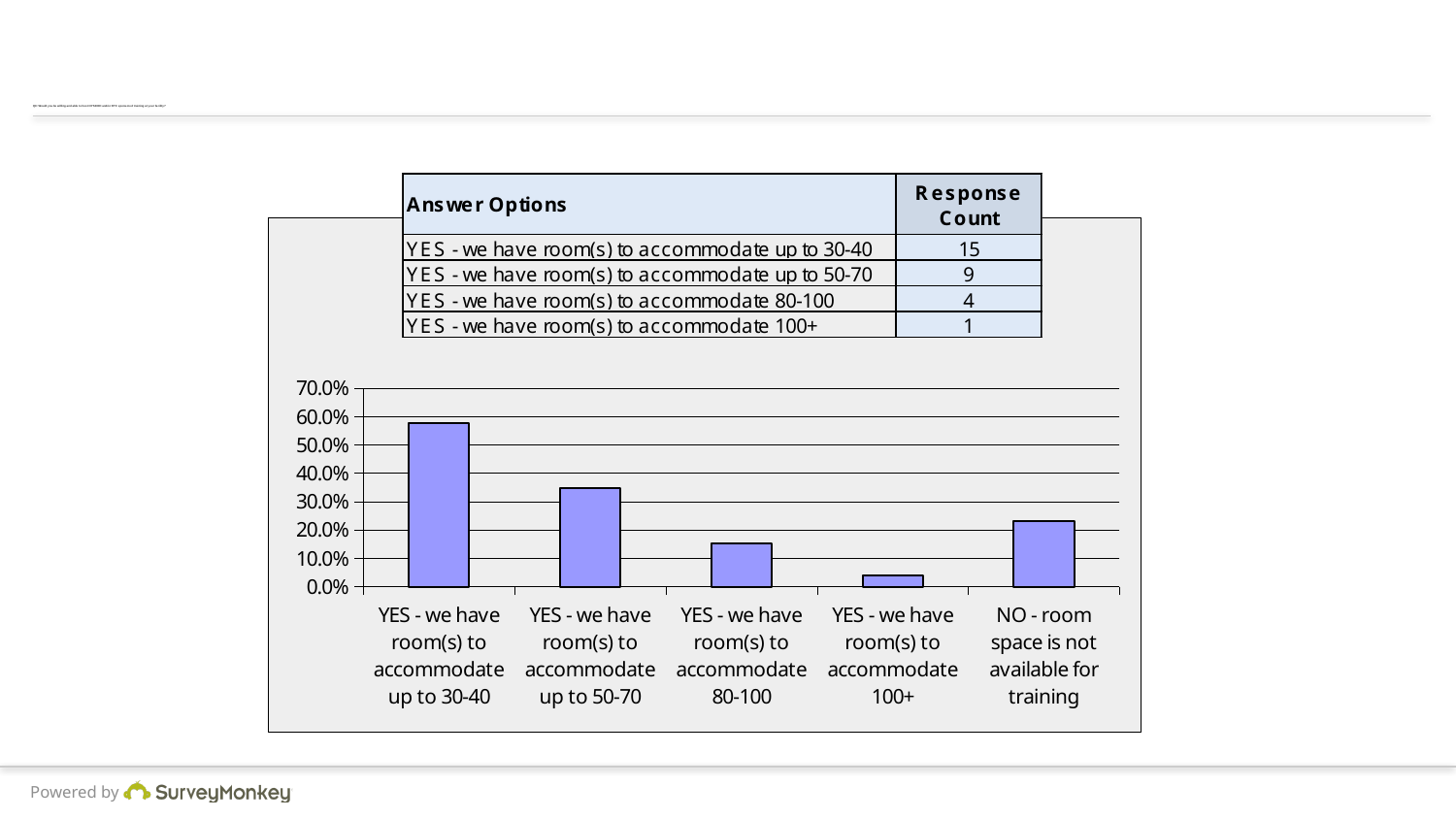
Across the four 'YES' categories from left to right, do the bars rise or fall? fall Is the bar for 'YES - we have room(s) to accommodate up to 50-70' greater or less than 40.0%? less Is the bar for 'NO - room space is not available for training' greater or less than 20.0%? greater According to the table above the chart, what is the response count for 'YES - we have room(s) to accommodate up to 30-40'? 15 What kind of chart is shown on the slide? bar chart Is the bar for 'YES - we have room(s) to accommodate up to 30-40' greater or less than 50.0%? greater Which category has the highest bar in the chart? YES - we have room(s) to accommodate up to 30-40 How many categories are shown on the x axis of the bar chart? 5 According to the table above the chart, what is the response count for 'YES - we have room(s) to accommodate 80-100'? 4 Which bar is taller: 'NO - room space is not available for training' or 'YES - we have room(s) to accommodate 80-100'? NO - room space is not available for training Which category has the lowest bar in the chart? YES - we have room(s) to accommodate 100+